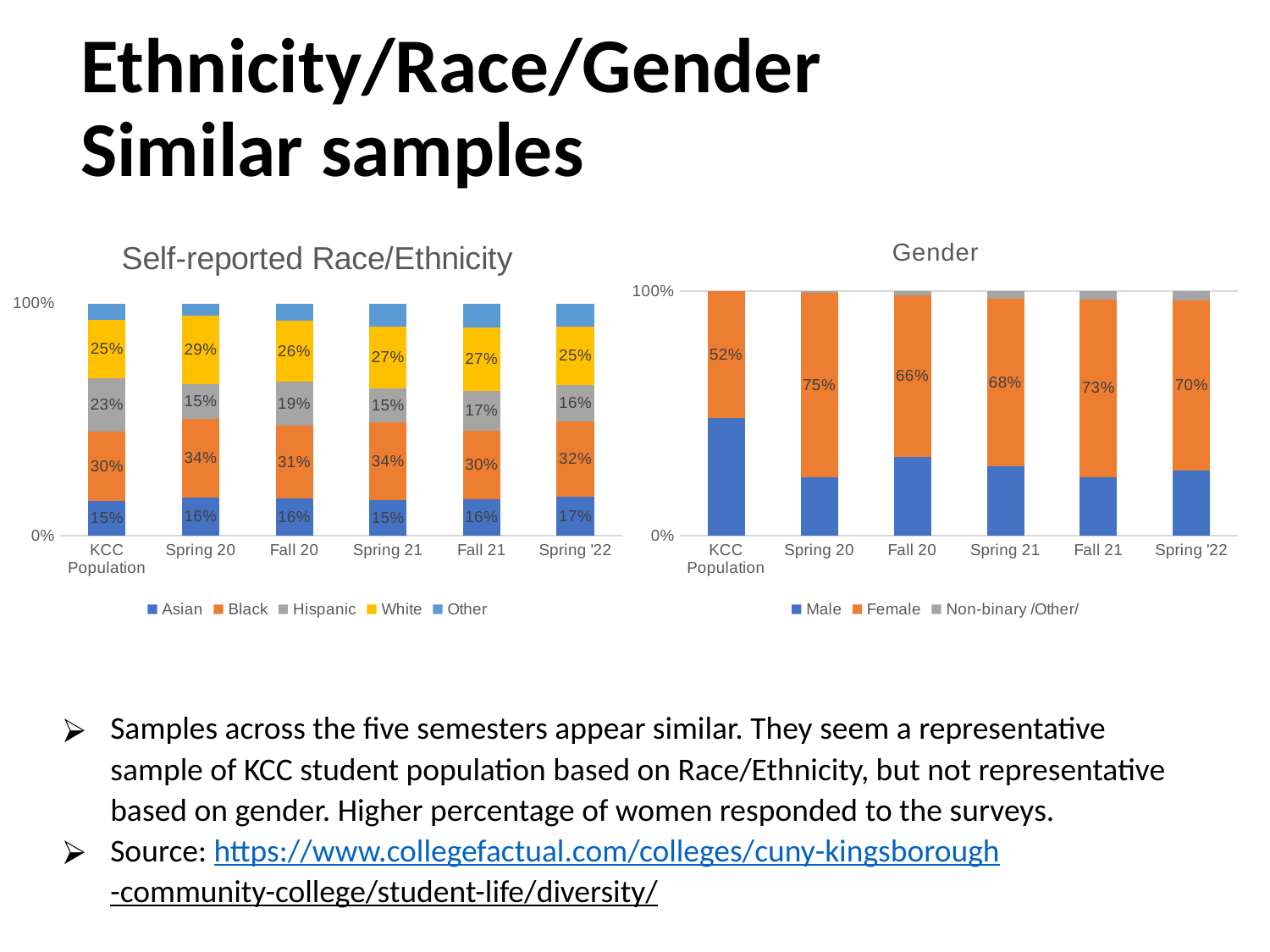
In the Gender chart, which category has the highest Female percentage? Spring 20 How many series does the legend of the Gender chart list? 3 In the Self-reported Race/Ethnicity chart, what is the White percentage for Fall 20? 26% What are the legend entries of the Self-reported Race/Ethnicity chart? Asian, Black, Hispanic, White, Other What kind of chart is the Gender chart? Stacked bar chart In the Gender chart, is the Male value for Spring 20 greater or less than 50%? less In the Gender chart, what percentage of the Fall 21 sample is Female? 73% In the Self-reported Race/Ethnicity chart, which has the larger Hispanic percentage, KCC Population or Spring 20? KCC Population How many categories are shown on the x axis of the Self-reported Race/Ethnicity chart? 6 In the Gender chart, what is the difference between the Female percentage for Spring 20 and for KCC Population? 23 percentage points In the Self-reported Race/Ethnicity chart, what percentage of the Spring 20 sample is Black? 34% In the Gender chart, which category has the lowest Female percentage? KCC Population